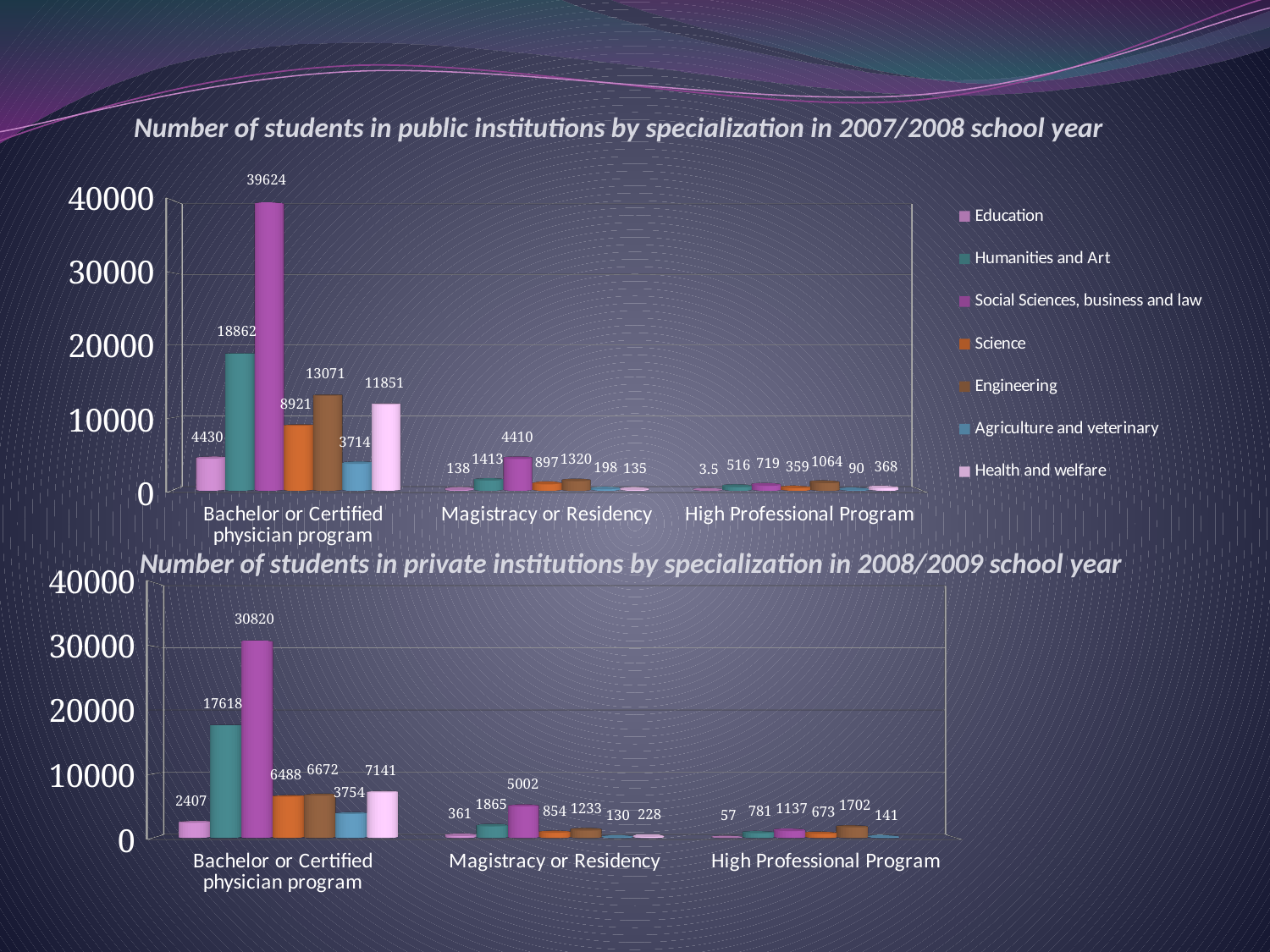
What kind of chart is the top chart (public institutions)? Bar chart In the top chart (public institutions), which is larger in the High Professional Program: Engineering or Social Sciences, business and law? Engineering In the chart titled 'Number of students in private institutions by specialization in 2008/2009 school year', what is the value for Humanities and Art in the Bachelor or Certified physician program? 17618 How many series does the legend list? 7 In the chart titled 'Number of students in public institutions by specialization in 2007/2008 school year', what is the value for Social Sciences, business and law in the Bachelor or Certified physician program? 39624 In the top chart (public institutions), what is the difference between Humanities and Art and Engineering in the Bachelor or Certified physician program? 5791 In the bottom chart (private institutions), what is the difference between Social Sciences, business and law and Science in the Bachelor or Certified physician program? 24332 In the bottom chart (private institutions), which specialization has the lowest value in the Magistracy or Residency category? Agriculture and veterinary In the chart titled 'Number of students in private institutions by specialization in 2008/2009 school year', what is the value for Engineering in the High Professional Program? 1702 In the top chart (public institutions), which specialization has the highest value in the Bachelor or Certified physician program? Social Sciences, business and law In the chart titled 'Number of students in public institutions by specialization in 2007/2008 school year', what is the value for Engineering in the Magistracy or Residency category? 1320 How many categories are shown on the x axis of the bottom chart (private institutions)? 3